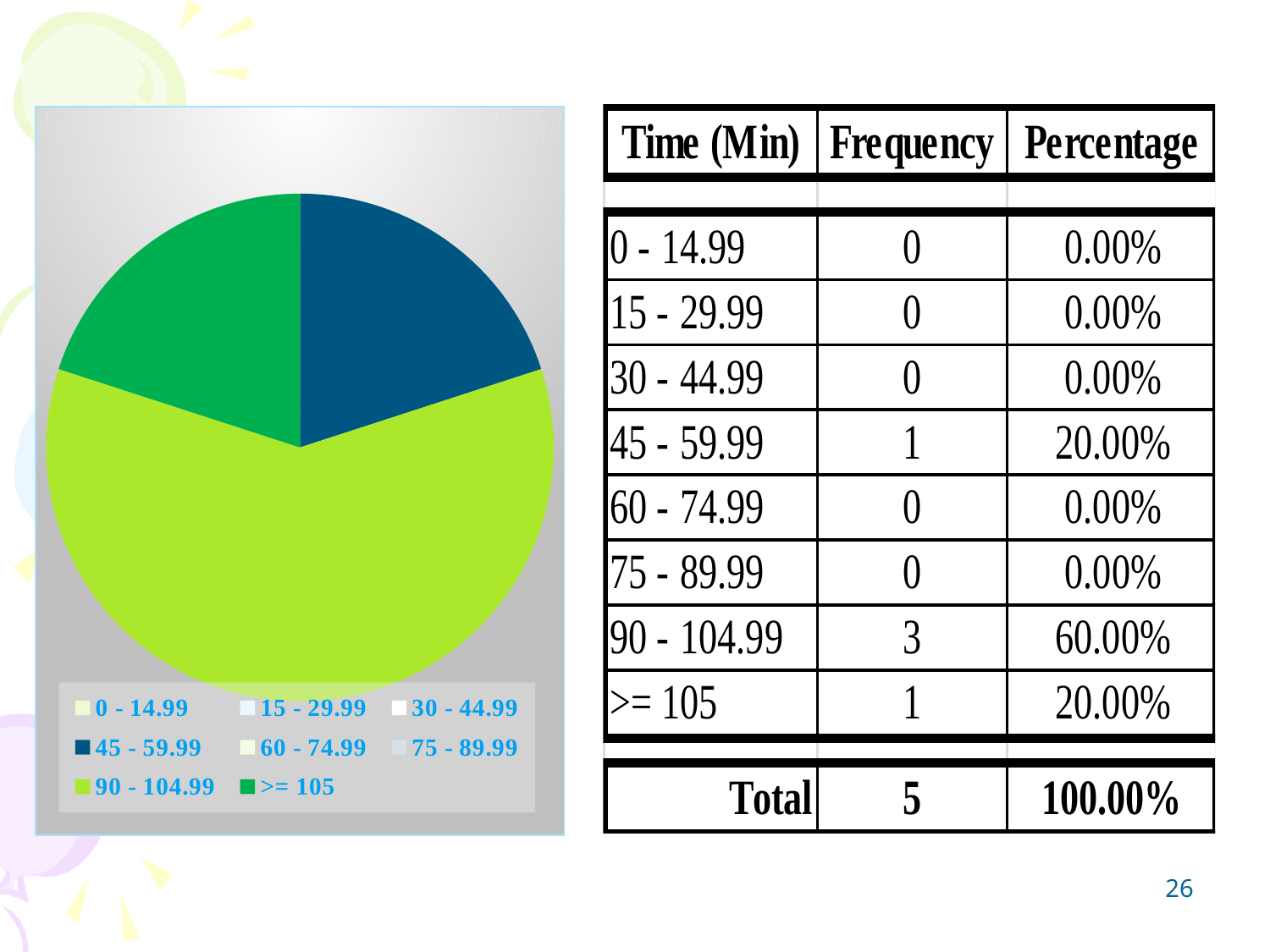
What share of the pie does the >= 105 category take? 20.00% How many slices are visible in the pie chart? 3 What colour is the largest slice in the pie chart? light green Which category has the largest slice in the pie chart? 90 - 104.99 What is the frequency for the 90 - 104.99 category? 3 What share of the pie does the 90 - 104.99 category take? 60.00% Which slice is larger in the pie chart, 90 - 104.99 or 45 - 59.99? 90 - 104.99 What is the total frequency across all categories? 5 What colour is the 45 - 59.99 slice in the pie chart? dark blue How many categories does the pie chart's legend list? 8 What share of the pie does the 45 - 59.99 category take? 20.00% What kind of chart is shown on the slide? pie chart